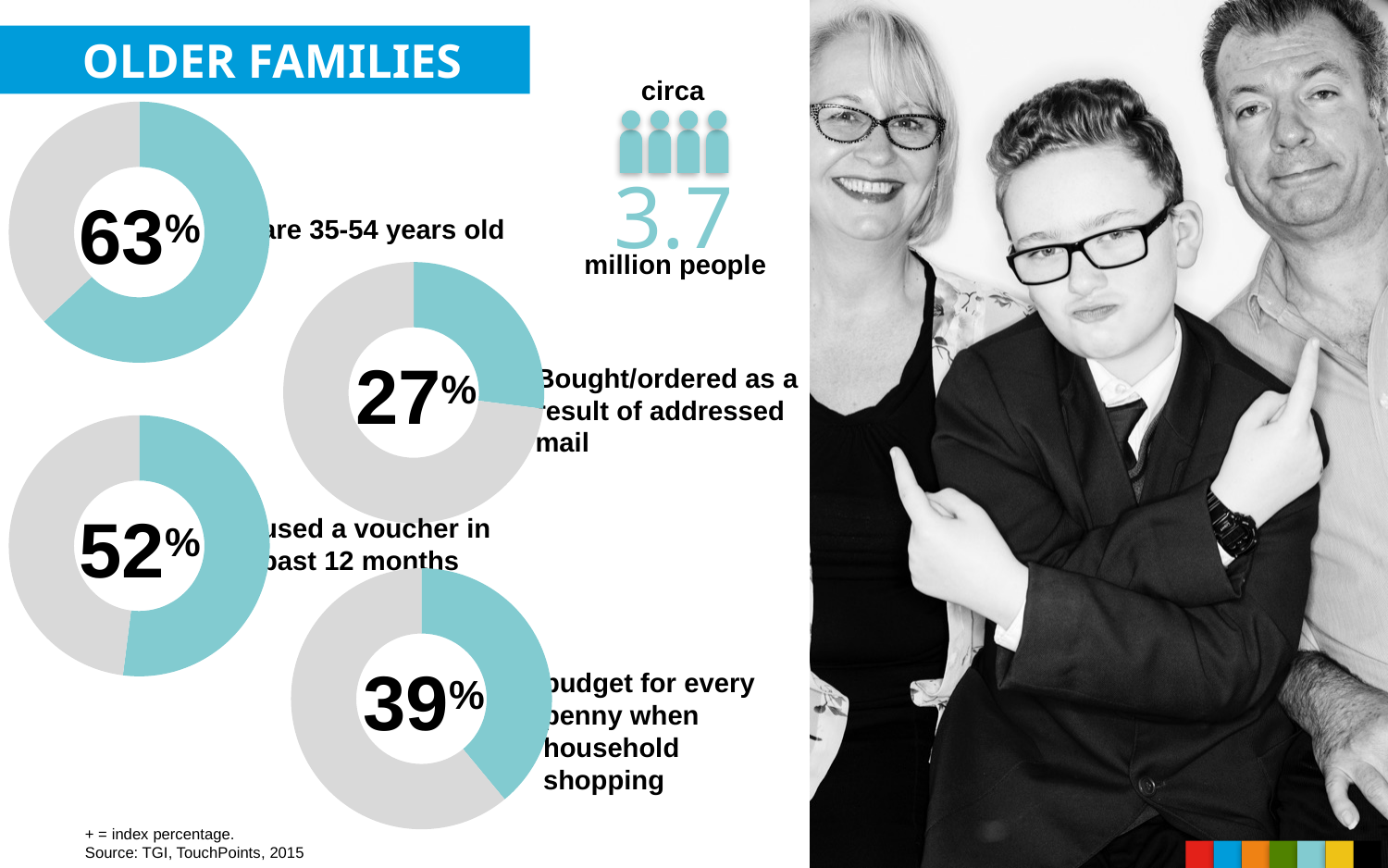
Which of the four donut charts shows the highest percentage? are 35-54 years old (63%) What is the title of the slide containing the donut charts? OLDER FAMILIES What percentage is shown in the donut chart for those who budget for every penny when household shopping? 39% What is the difference between the percentage who are 35-54 years old and the percentage who used a voucher in the past 12 months? 11 percentage points According to the people icon graphic, roughly how many people are in the Older Families group? circa 3.7 million people Which of the four donut charts shows the lowest percentage? Bought/ordered as a result of addressed mail (27%) How many donut charts are shown on the slide? 4 What percentage is shown in the donut chart for those who bought/ordered as a result of addressed mail? 27% What percentage is shown in the donut chart for those who are 35-54 years old? 63% Which is larger: the percentage who budget for every penny when household shopping or the percentage who bought/ordered as a result of addressed mail? budget for every penny when household shopping (39%) What percentage is shown in the donut chart for those who used a voucher in the past 12 months? 52% What type of chart is used to display the percentages on the slide? Donut (pie) chart